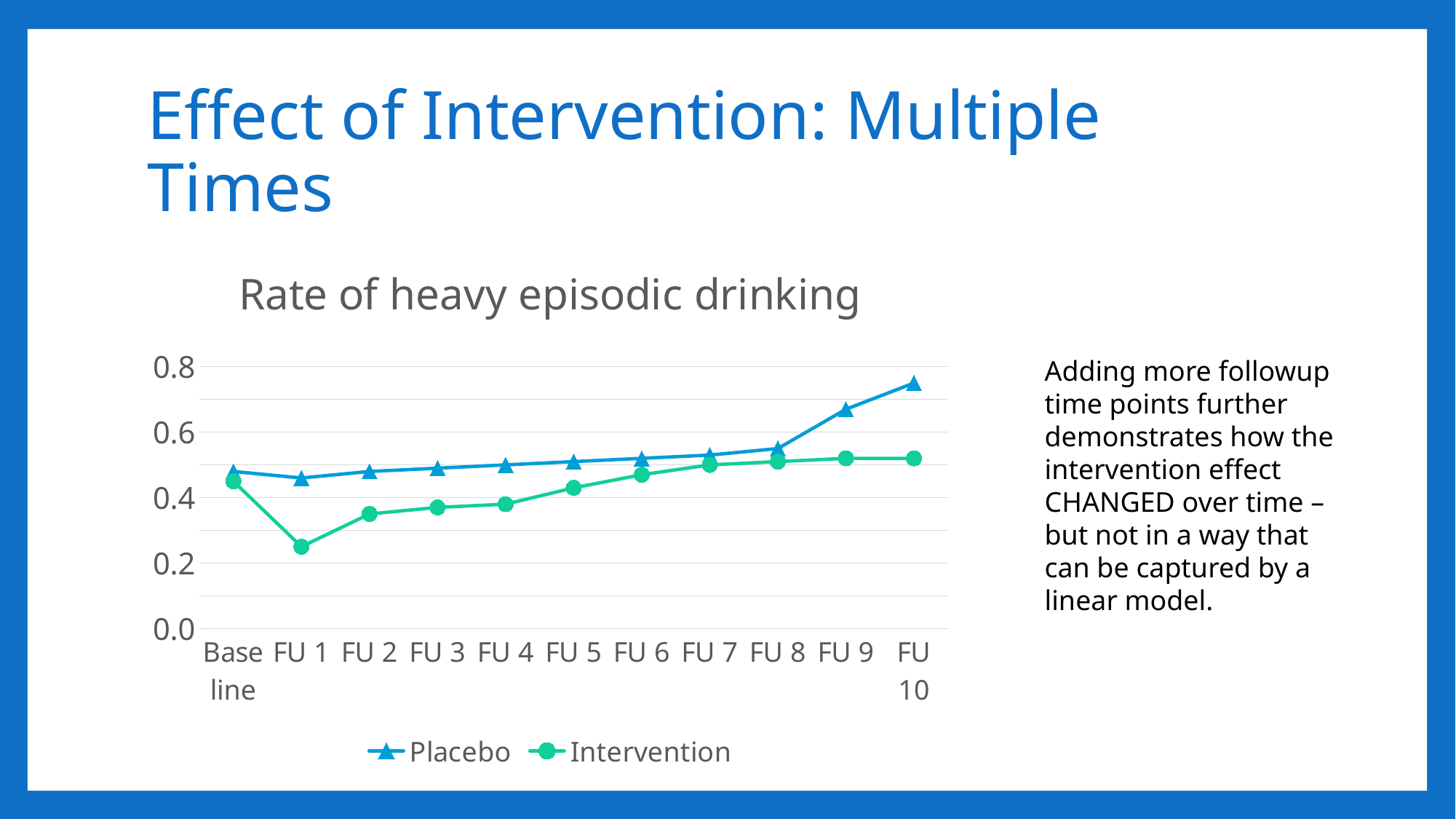
Which series is drawn with triangle markers? Placebo How many time points are plotted along the x axis? 11 Does the Placebo series rise or fall from FU 8 to FU 10? rise Is the Intervention value at FU 10 greater or less than 0.6? less Is the Intervention value at FU 1 greater or less than 0.4? less At FU 3, which series has the higher value, Placebo or Intervention? Placebo What is the title of the chart? Rate of heavy episodic drinking At which time point is the Intervention series lowest? FU 1 At which time point is the Placebo series highest? FU 10 What kind of chart is shown on the slide? line chart How many series does the legend list? 2 Is the Placebo value at FU 10 greater or less than 0.6? greater